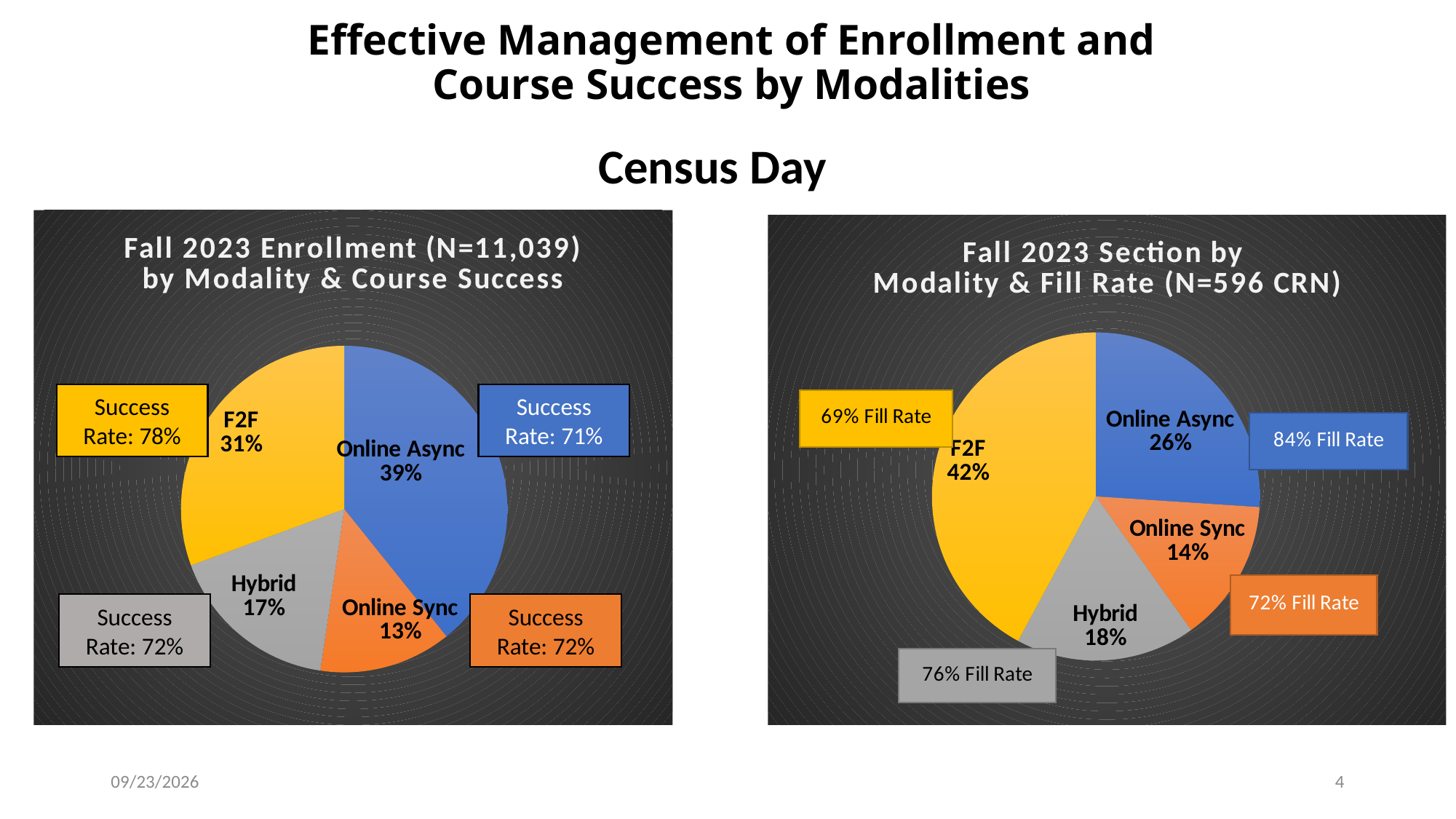
In the left chart (Fall 2023 Enrollment by Modality & Course Success), which modality has the largest share of enrollment? Online Async In the right chart (Fall 2023 Section by Modality & Fill Rate), which has a larger share of sections, Hybrid or Online Sync? Hybrid In the left chart (Fall 2023 Enrollment by Modality & Course Success), how many modality slices does the pie have? 4 In the right chart (Fall 2023 Section by Modality & Fill Rate), what fill rate is shown for Online Async? 84% Fill Rate In the right chart (Fall 2023 Section by Modality & Fill Rate), what share of sections is F2F? 42% In the left chart (Fall 2023 Enrollment by Modality & Course Success), what is the difference in enrollment share between Online Async and F2F? 8% In the left chart (Fall 2023 Enrollment by Modality & Course Success), which modality has the smallest share of enrollment? Online Sync In the left chart (Fall 2023 Enrollment by Modality & Course Success), what is the success rate shown for F2F? 78% In the right chart (Fall 2023 Section by Modality & Fill Rate), what is the difference in fill rate between Online Async and F2F? 15% In the right chart (Fall 2023 Section by Modality & Fill Rate), which modality has the largest share of sections? F2F What kind of chart is the right chart (Fall 2023 Section by Modality & Fill Rate)? Pie chart In the left chart (Fall 2023 Enrollment by Modality & Course Success), what share of enrollment is Online Async? 39%